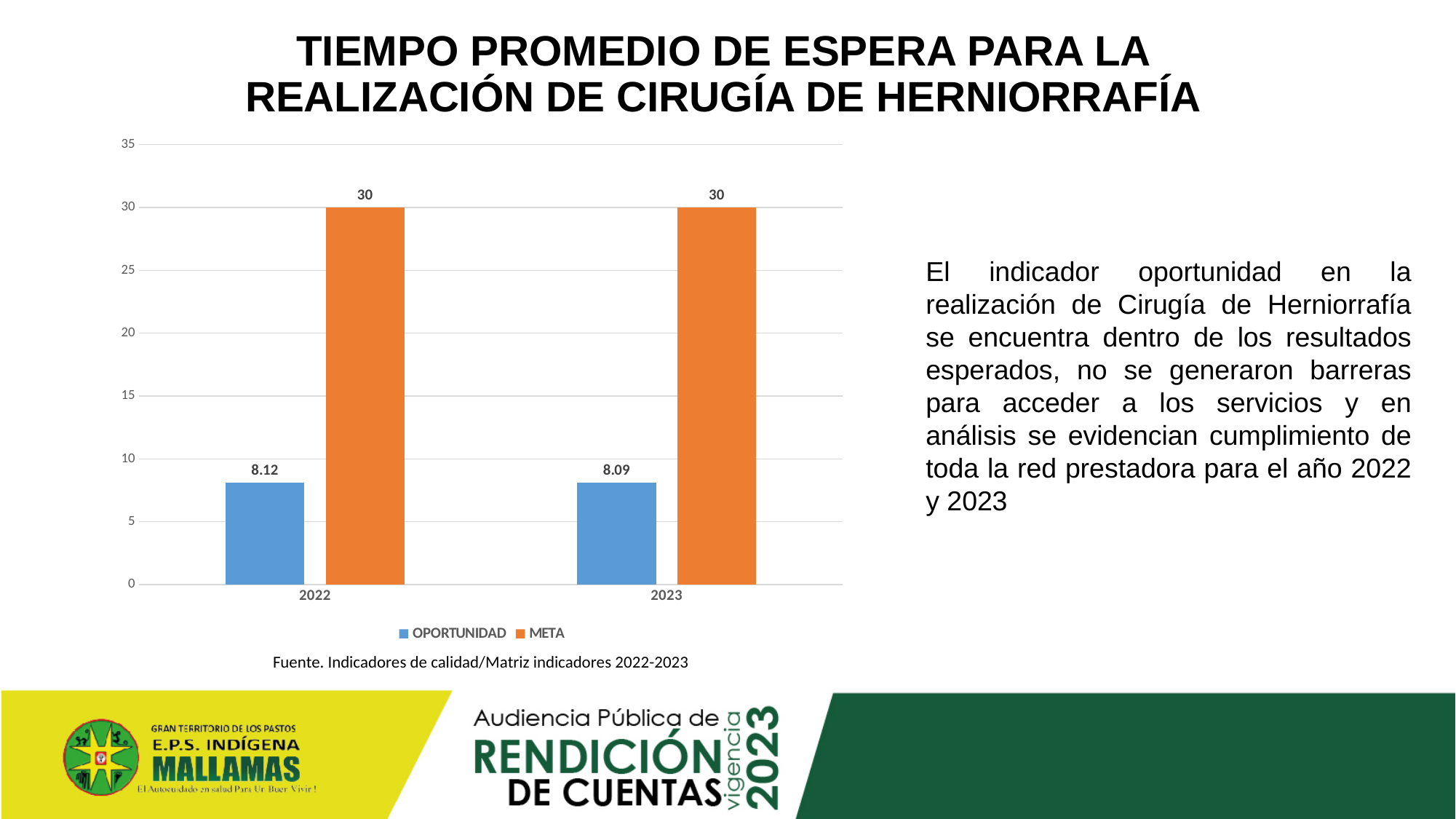
How many series does the legend list? 2 What is the OPORTUNIDAD value for 2023? 8.09 How many years are shown on the x axis? 2 What is the difference between the META and OPORTUNIDAD values for 2022? 21.88 Which series is shown in orange? META What is the difference between the META and OPORTUNIDAD values for 2023? 21.91 Is the OPORTUNIDAD value for 2022 greater or less than 10? less What is the META value for 2023? 30 What kind of chart is shown on the slide? bar chart What is the META value for 2022? 30 What is the OPORTUNIDAD value for 2022? 8.12 Which is larger in 2023, the OPORTUNIDAD value or the META value? META